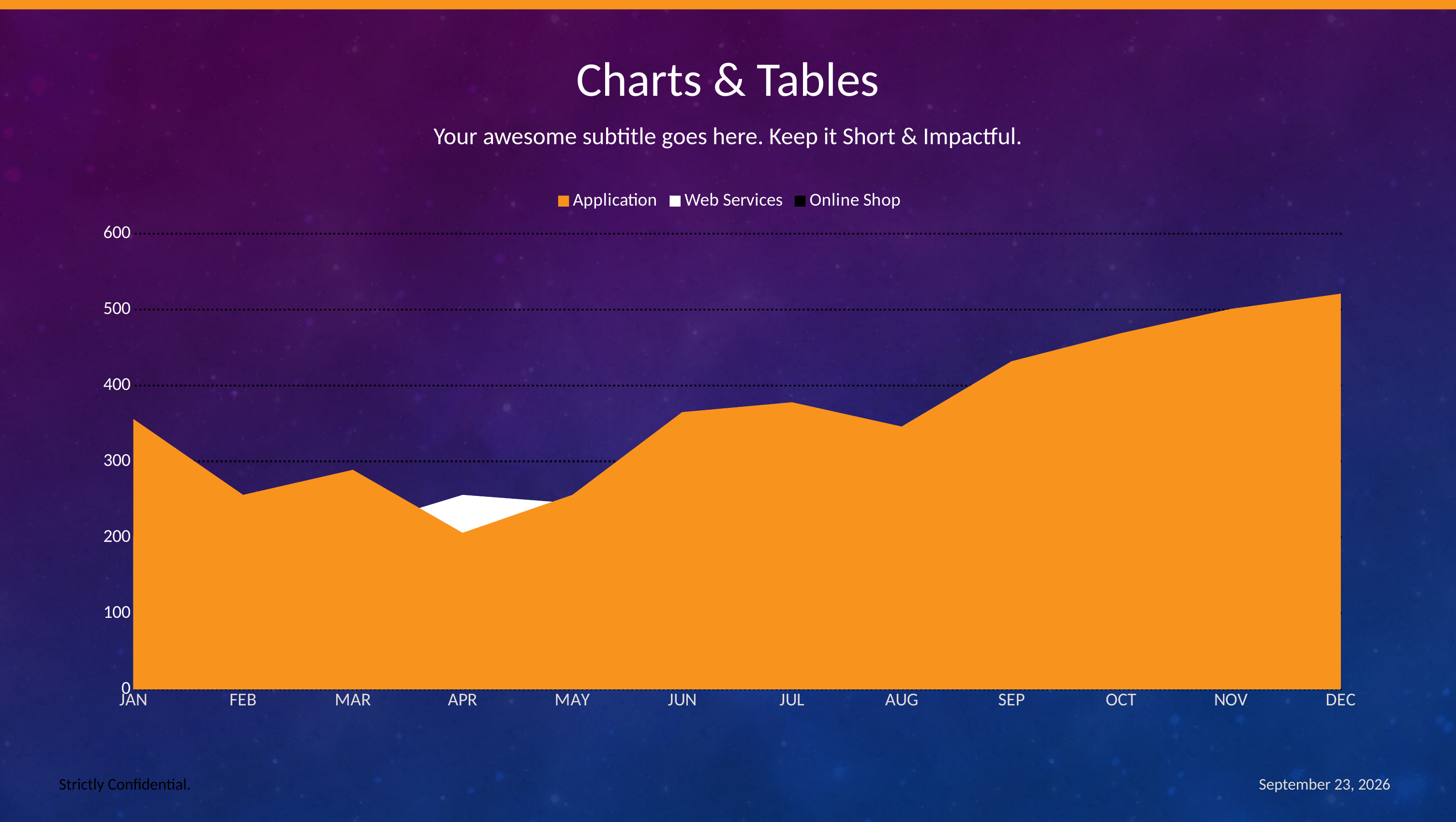
Is the Application value for SEP greater or less than 400? greater How many months are shown along the x axis? 12 Which colour represents the Application series in the legend? Orange In which month is the Application series lowest? APR Is the Application value for FEB greater or less than 300? less Which month has the larger Application value, JAN or FEB? JAN Is the Application value for DEC greater or less than 500? greater In which month is the Application series highest? DEC Do the Application values rise or fall from AUG to DEC? rise How many series does the legend list? 3 What kind of chart is shown on the slide? Area chart